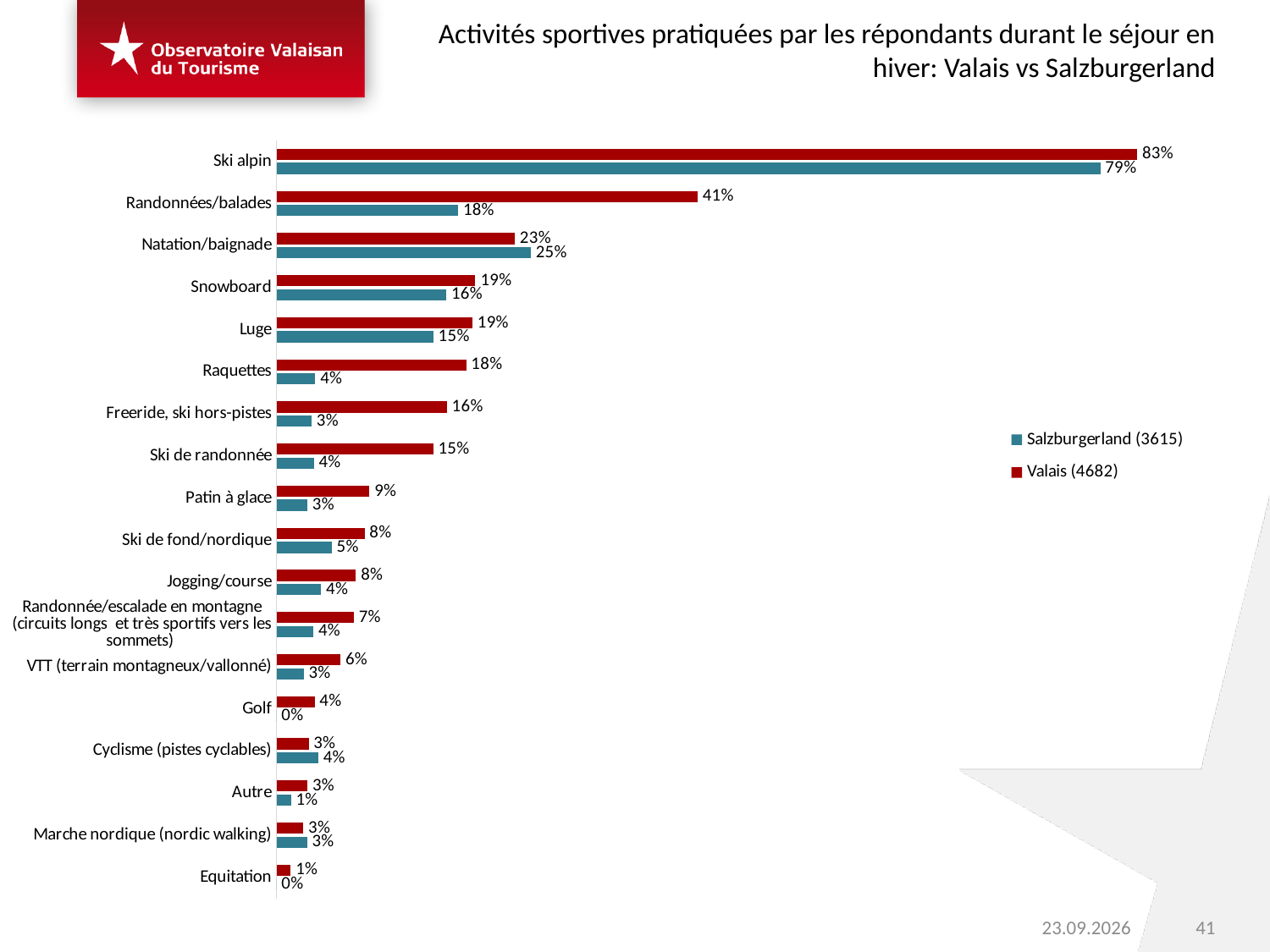
Which activity has the highest value for Valais? Ski alpin Which activity has the lowest value for Valais? Equitation For Natation/baignade, which is larger: the Valais value or the Salzburgerland value? Salzburgerland What is the value for Salzburgerland for Randonnées/balades? 18% What is the difference between the Valais and Salzburgerland values for Ski alpin? 4% What is the value for Valais for Ski alpin? 83% What kind of chart is shown on the slide? Bar chart How many series does the legend list? 2 What is the value for Salzburgerland for Natation/baignade? 25% What is the value for Valais for Raquettes? 18% What is the difference between the Valais and Salzburgerland values for Randonnées/balades? 23% How many activities are listed on the chart? 18